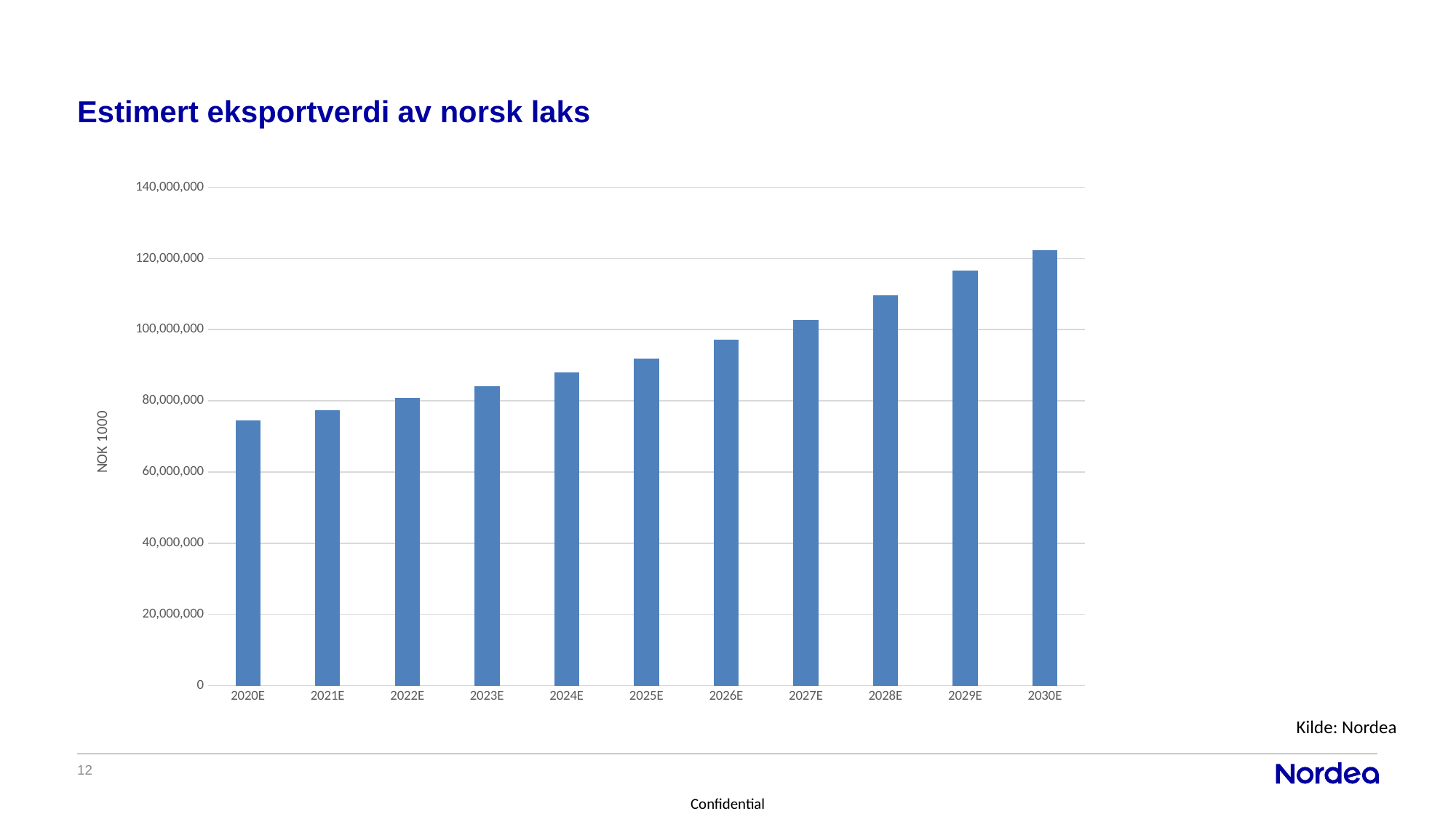
Is the value for 2020E greater or less than 80,000,000? less Is the value for 2028E greater or less than 100,000,000? greater What type of chart is shown on the slide? bar chart Which year has the highest estimated export value? 2030E What is the title of the chart? Estimert eksportverdi av norsk laks Do the values rise or fall from 2020E to 2030E? rise Is the value for 2024E greater or less than 80,000,000? greater Which is larger, the value for 2026E or the value for 2029E? 2029E What is the label on the y axis of the chart? NOK 1000 Which year has the lowest estimated export value? 2020E How many years (bars) are shown on the x axis of the chart? 11